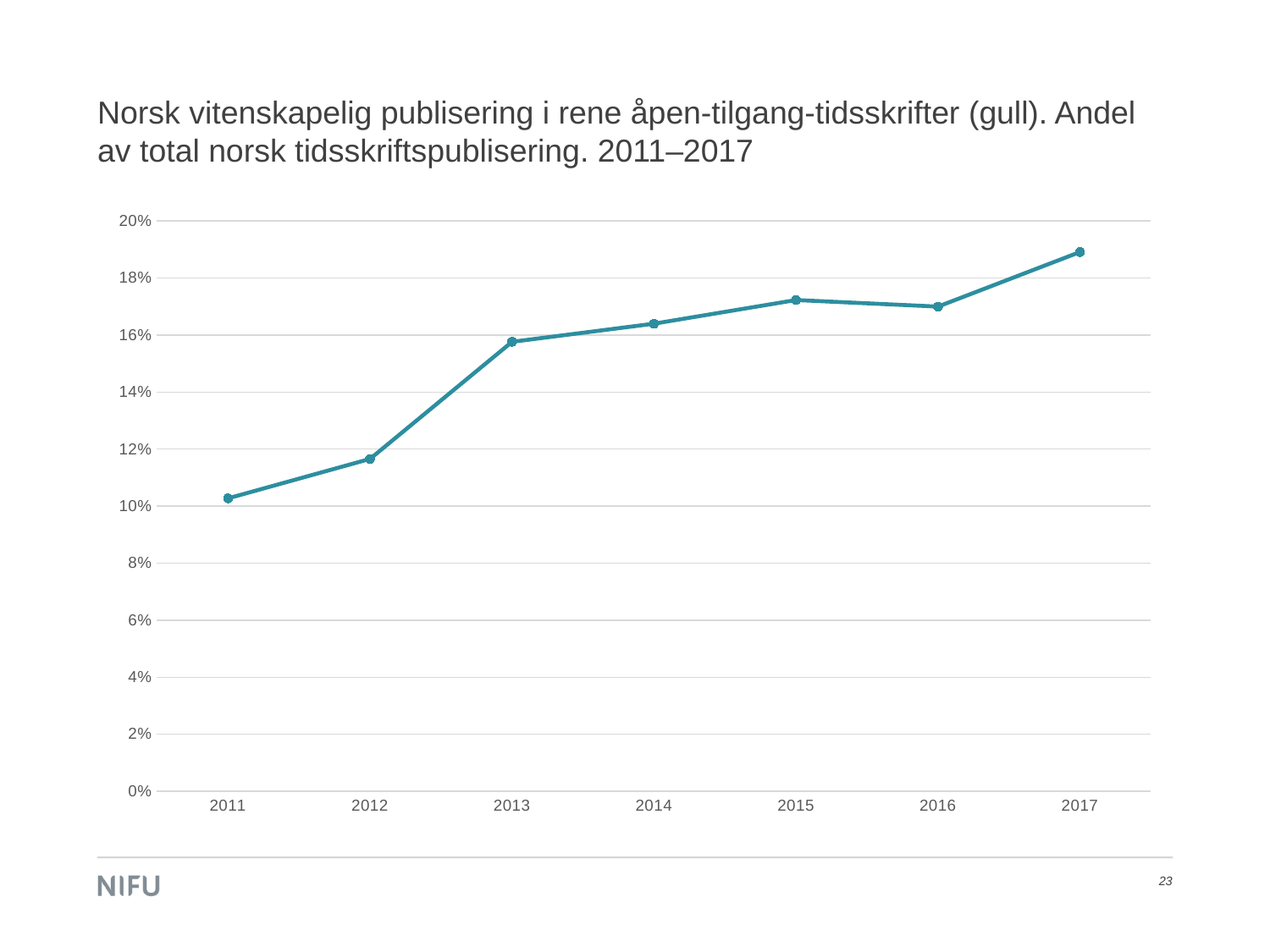
What is the highest value shown on the y axis? 20% Is the value for 2016 greater or less than 18%? less Which year has the highest share of publishing in gold open-access journals? 2017 Is the value for 2017 greater or less than 18%? greater How many years are plotted on the x axis? 7 Is the value for 2011 greater or less than 12%? less Do the values generally rise or fall from 2011 to 2017? rise What kind of chart is shown on the slide? line chart Which is larger, the value for 2013 or the value for 2012? 2013 Which year has the lowest share of publishing in gold open-access journals? 2011